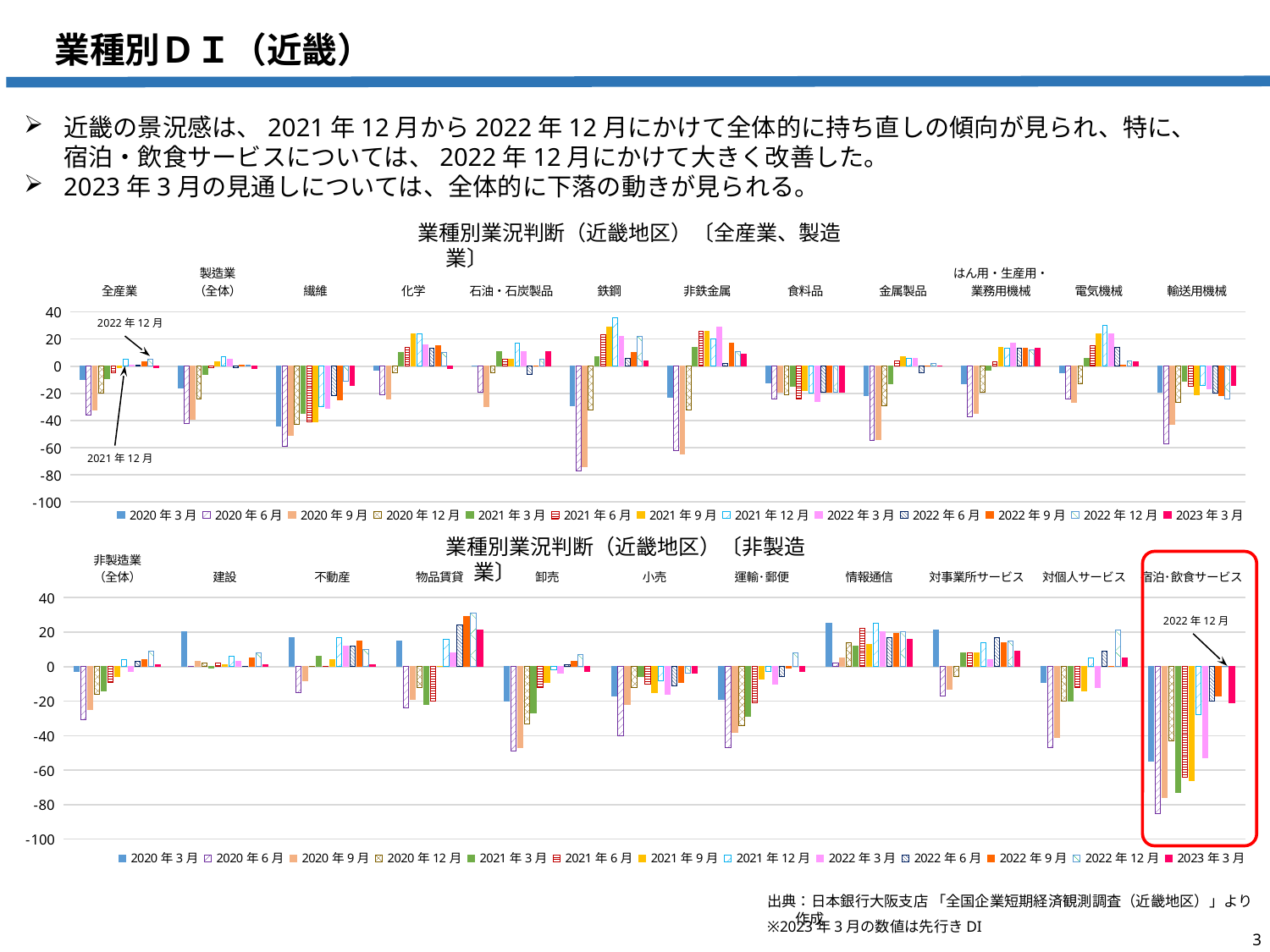
In the bottom chart (非製造業), which industry category is highlighted with a red box? 宿泊・飲食サービス In the bottom chart (非製造業), do the bars for 宿泊・飲食サービス rise or fall from 2020年6月 to 2022年12月? rise How many industry categories are shown on the x axis of the top chart (全産業、製造業)? 12 How many industry categories are shown on the x axis of the bottom chart (非製造業)? 11 How many series does the legend of the top chart (全産業、製造業) list? 13 In the bottom chart (非製造業), which industry has the lowest bar of any series? 宿泊・飲食サービス In the bottom chart (非製造業), is the value for 宿泊・飲食サービス in 2020年6月 greater or less than -60? less What kind of chart is the top chart titled 業種別業況判断（近畿地区）〔全産業、製造業〕? bar chart In the top chart (全産業、製造業), which industry has the lowest bar of any series? 鉄鋼 In the top chart (全産業、製造業), is the value for 鉄鋼 in 2020年6月 greater or less than -60? less In the top chart (全産業、製造業), which is lower for 2020年6月: 鉄鋼 or 繊維? 鉄鋼